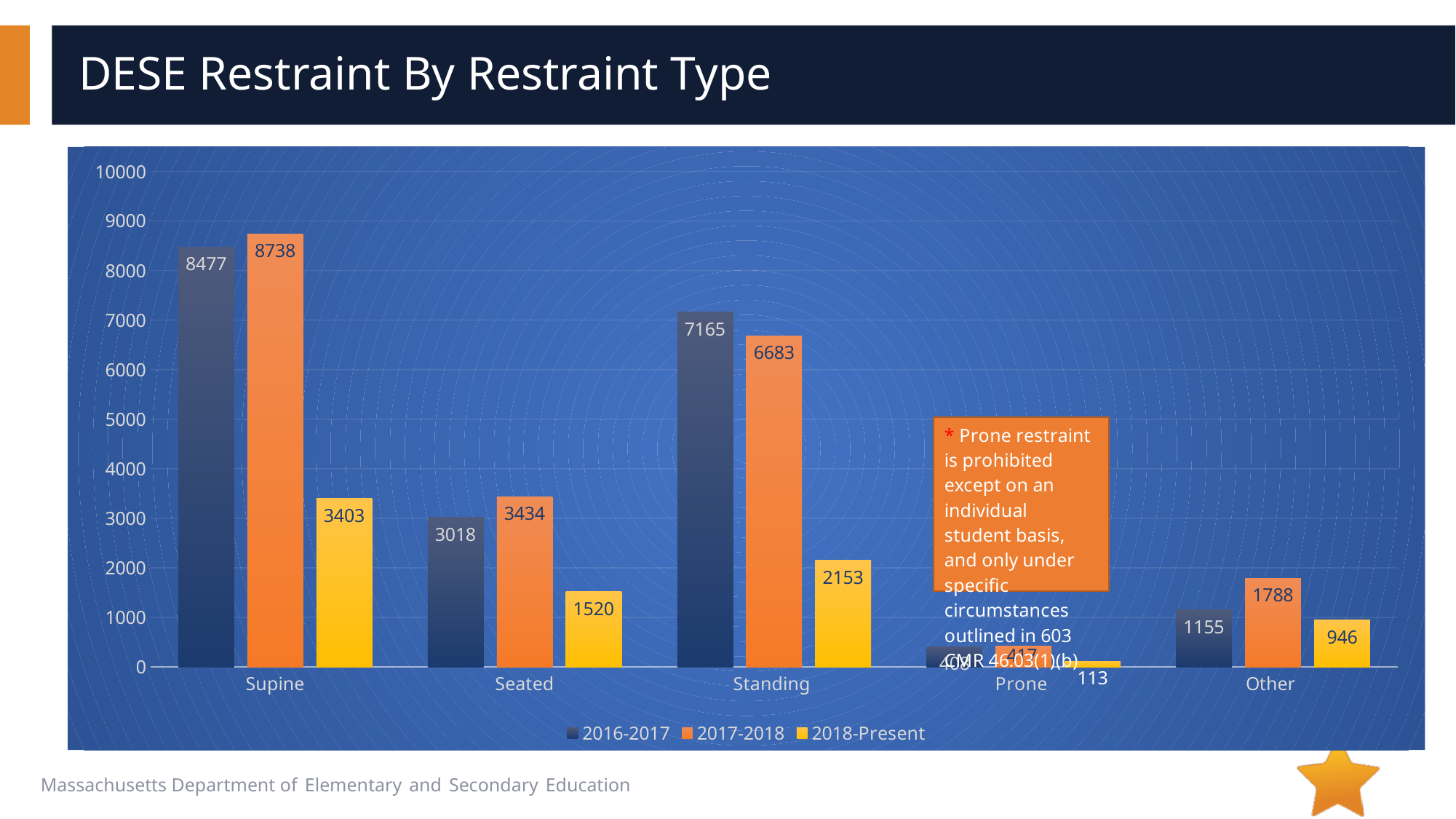
What is the value for Supine in the 2017-2018 series? 8738 How many series does the legend list? 3 What is the value for Standing in the 2016-2017 series? 7165 Which is larger for Seated: the 2016-2017 value or the 2017-2018 value? 2017-2018 What is the value for Other in the 2017-2018 series? 1788 What kind of chart is shown on the slide? Bar chart How many restraint type categories are shown on the x axis? 5 Which restraint type has the highest value in the 2016-2017 series? Supine Is the 2018-Present value for Supine greater or less than 3000? greater What is the value for Seated in the 2018-Present series? 1520 What is the difference between the 2016-2017 and 2017-2018 values for Standing? 482 Which restraint type has the lowest value in the 2018-Present series? Prone